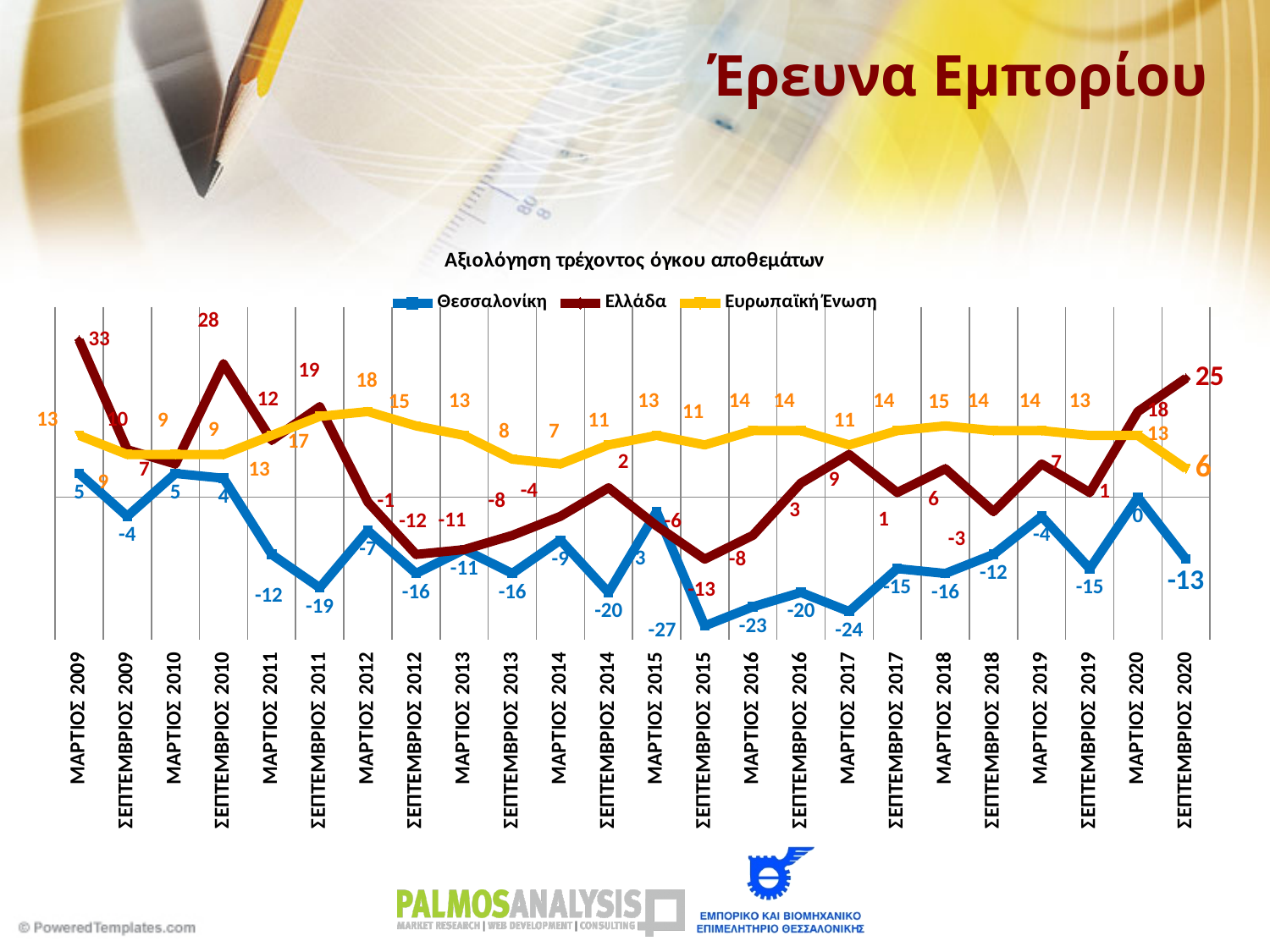
What type of chart is shown on the slide? line chart In which period does the Θεσσαλονίκη series reach its lowest value? ΣΕΠΤΕΜΒΡΙΟΣ 2015 What is the value for Ευρωπαϊκή Ένωση in ΣΕΠΤΕΜΒΡΙΟΣ 2020? 6 What is the value for Θεσσαλονίκη in ΣΕΠΤΕΜΒΡΙΟΣ 2015? -27 What is the title of the chart? Αξιολόγηση τρέχοντος όγκου αποθεμάτων How many series does the legend list? 3 Does the Θεσσαλονίκη series rise or fall between ΜΑΡΤΙΟΣ 2020 and ΣΕΠΤΕΜΒΡΙΟΣ 2020? fall Which series has the higher value in ΜΑΡΤΙΟΣ 2020, Ελλάδα or Θεσσαλονίκη? Ελλάδα In which period does the Ελλάδα series reach its highest value? ΜΑΡΤΙΟΣ 2009 What is the value for Ελλάδα in ΣΕΠΤΕΜΒΡΙΟΣ 2020? 25 What is the difference between the Ελλάδα value and the Θεσσαλονίκη value in ΣΕΠΤΕΜΒΡΙΟΣ 2020? 38 How many time points are plotted along the x axis? 24